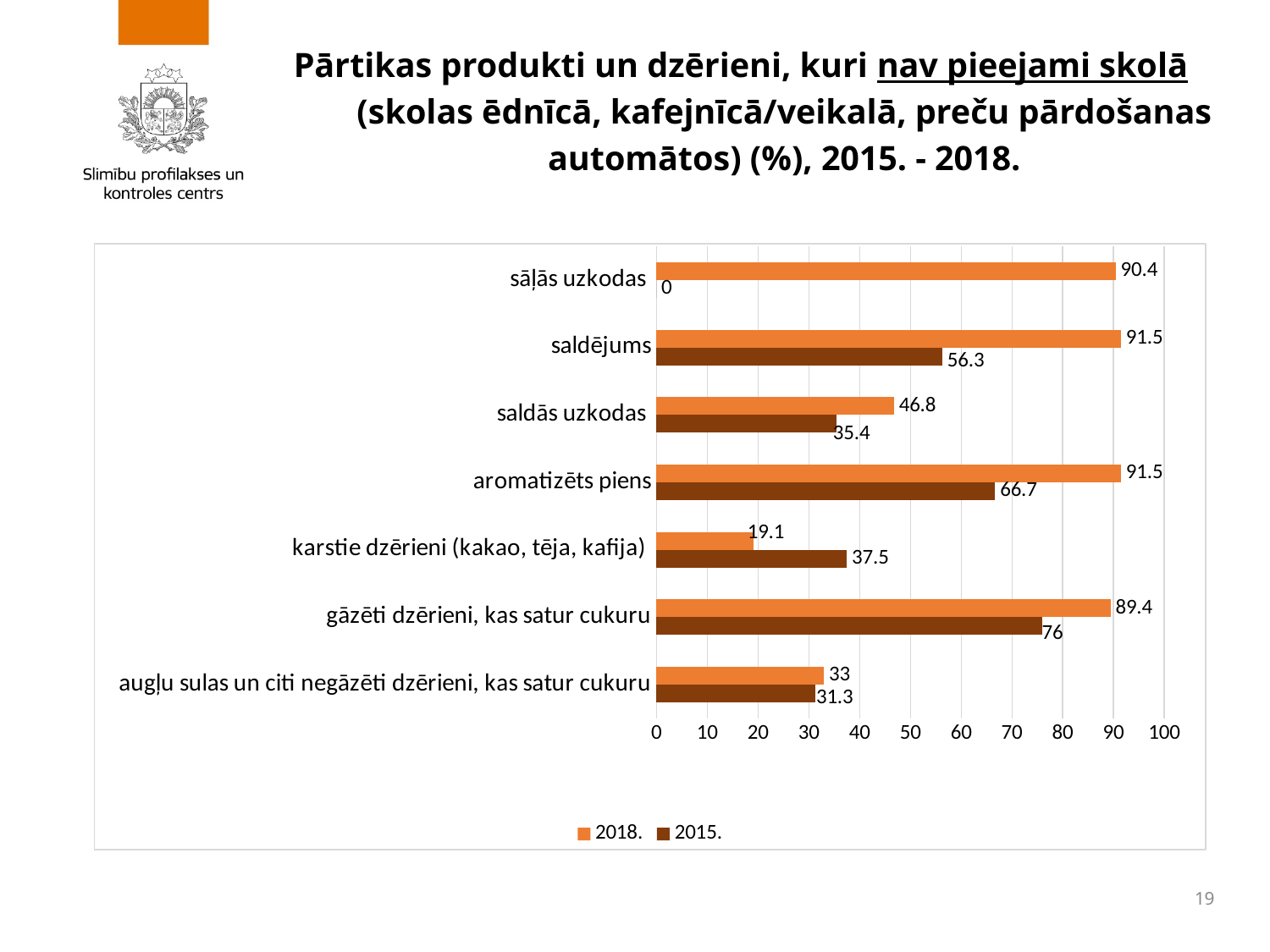
Which category has the highest 2015 value? gāzēti dzērieni, kas satur cukuru Which category has the lowest 2018 value? karstie dzērieni (kakao, tēja, kafija) How many categories are shown on the chart? 7 What is the 2015 value for sāļās uzkodas? 0 What kind of chart is shown on the slide? bar chart What is the difference between the 2018 and 2015 values for gāzēti dzērieni, kas satur cukuru? 13.4 For karstie dzērieni (kakao, tēja, kafija), which year has the larger value, 2018 or 2015? 2015 How many series does the legend list? 2 What is the difference between the 2018 and 2015 values for saldējums? 35.2 What is the 2018 value for karstie dzērieni (kakao, tēja, kafija)? 19.1 What is the 2018 value for saldējums? 91.5 What is the 2015 value for aromatizēts piens? 66.7